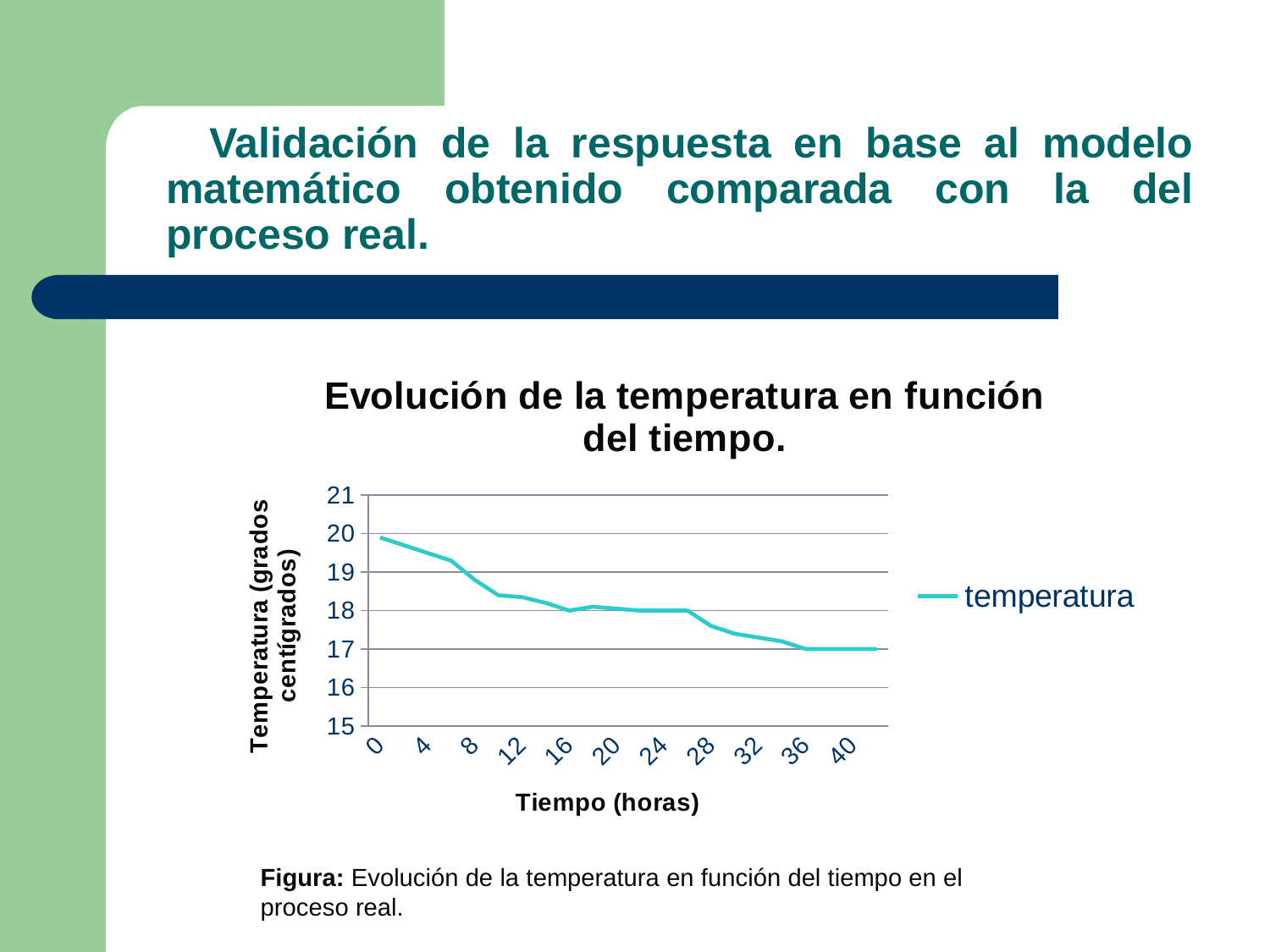
At which time is the temperature highest? 0 Do the temperature values rise or fall as time increases along the x axis? fall Is the temperature at time 0 greater or less than 19? greater Is the temperature at time 8 greater or less than 18? greater Is the temperature at time 20 greater or less than 19? less What is the title of the chart? Evolución de la temperatura en función del tiempo. How many series does the legend list? 1 What is the name of the series shown in the legend? temperatura What kind of chart is shown on the slide? line chart Which is larger, the temperature at time 0 or at time 40? time 0